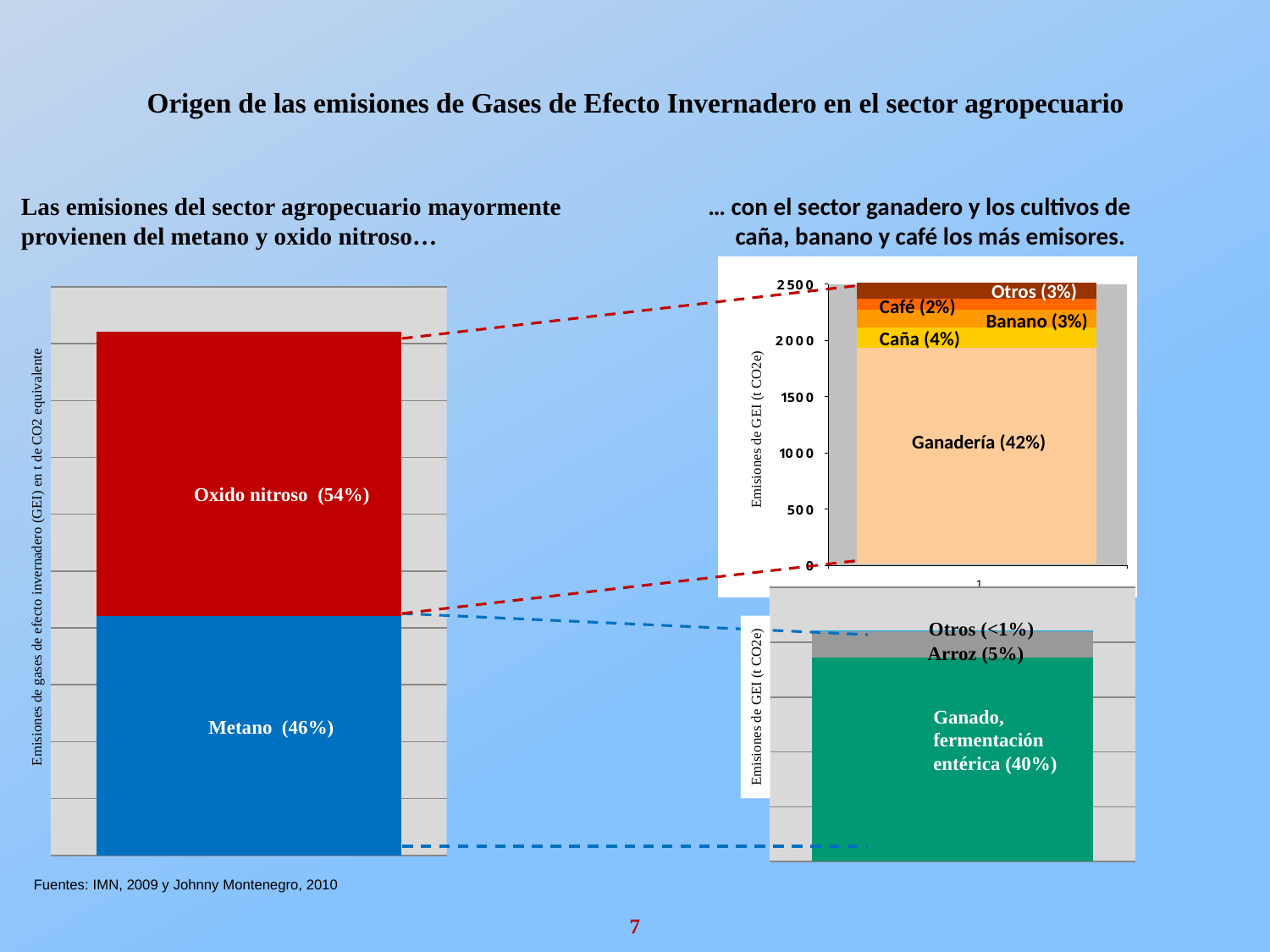
In the top-right chart, which segment has the smallest percentage? Café (2%) In the large chart on the left, what percentage is shown for Oxido nitroso? 54% In the top-right chart, is the top of the stacked bar greater or less than 2000 on the y axis? greater In the large chart on the left, which segment is larger, Oxido nitroso or Metano? Oxido nitroso In the large chart on the left, what percentage is shown for Metano? 46% In the top-right chart, what percentage is shown for Ganadería? 42% In the top-right chart, what percentage is shown for Caña? 4% What kind of chart is the large chart on the left? Stacked bar chart How many segments make up the stacked bar in the top-right chart? 5 In the bottom-right chart, what percentage is shown for Ganado, fermentación entérica? 40% In the large chart on the left, what is the difference in percentage points between Oxido nitroso and Metano? 8 In the bottom-right chart, what percentage is shown for Arroz? 5%